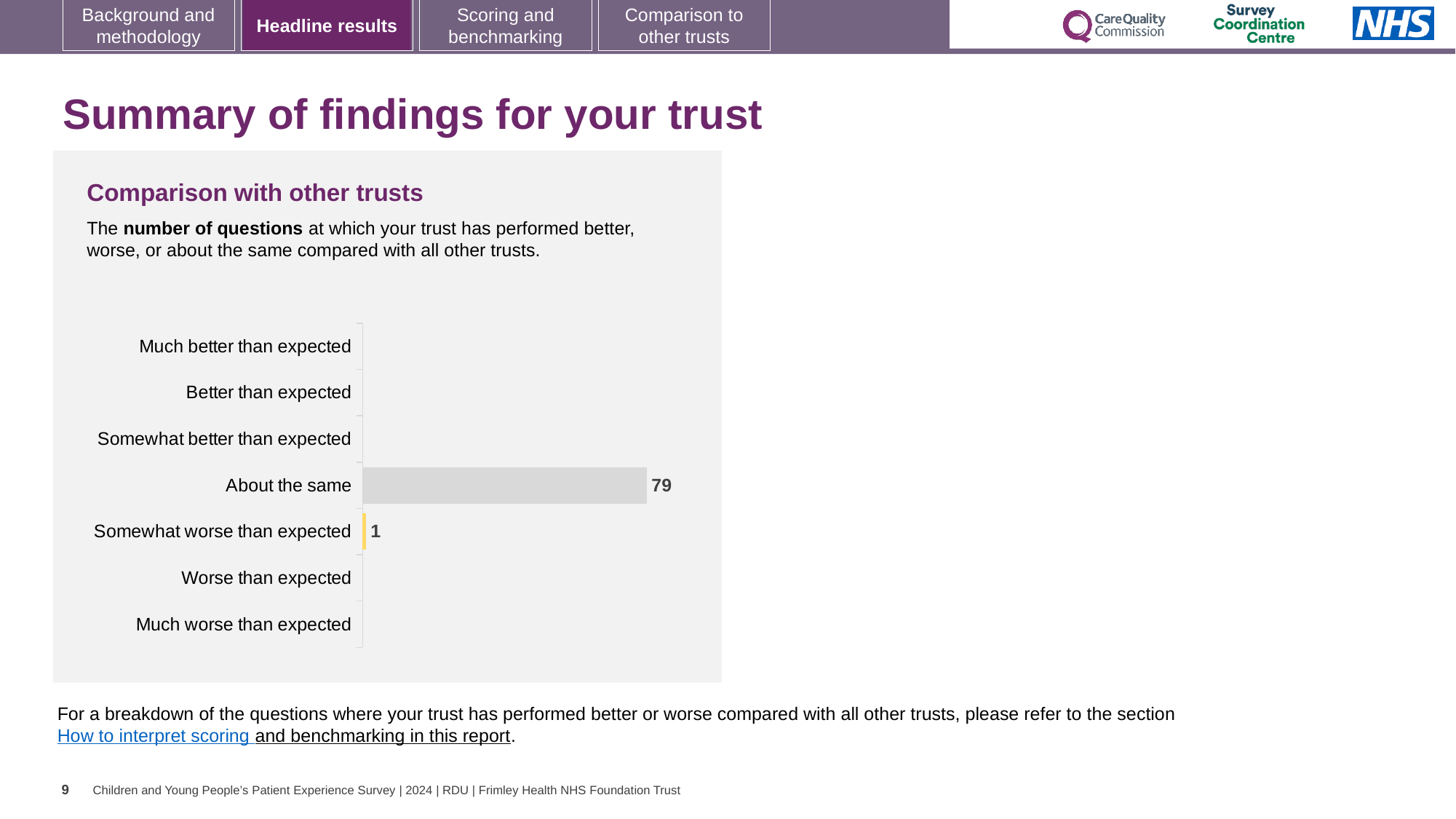
What kind of chart is shown on the slide? Bar chart What colour is the bar for 'Somewhat worse than expected'? Yellow Which is larger: the value for 'About the same' or the value for 'Somewhat worse than expected'? About the same What is the difference between the values for 'About the same' and 'Somewhat worse than expected'? 78 What is the value for 'Somewhat worse than expected' in the Comparison with other trusts chart? 1 Which category has the highest value in the Comparison with other trusts chart? About the same What is the title of the chart on the slide? Comparison with other trusts What is the total of the two labelled bar values in the chart? 80 How many categories are listed on the vertical axis of the Comparison with other trusts chart? 7 What is the value for 'About the same' in the Comparison with other trusts chart? 79 How many categories in the chart have a visible bar? 2